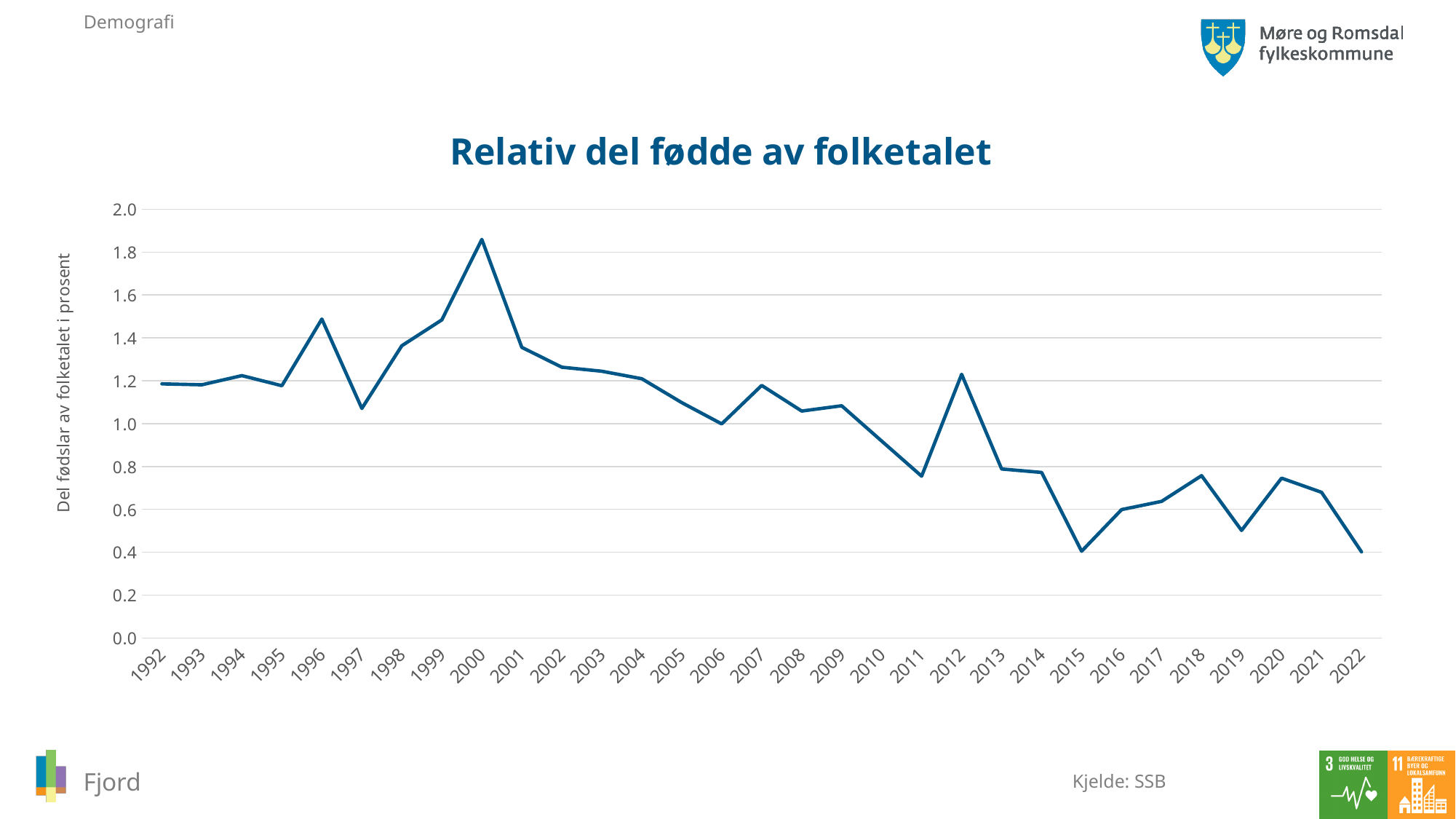
Which year has the larger value, 2012 or 2013? 2012 Which year has the larger value, 1996 or 1997? 1996 Is the value for 1996 greater or less than 1.4? greater What is the title of the chart? Relativ del fødde av folketalet Overall, do the values rise or fall from 1992 to 2022? fall What kind of chart is shown on the slide? line chart Is the value for 2011 greater or less than 1.0? less Is the value for 2022 greater or less than 0.6? less How many years are plotted along the x axis? 31 Which year has the highest value in the chart? 2000